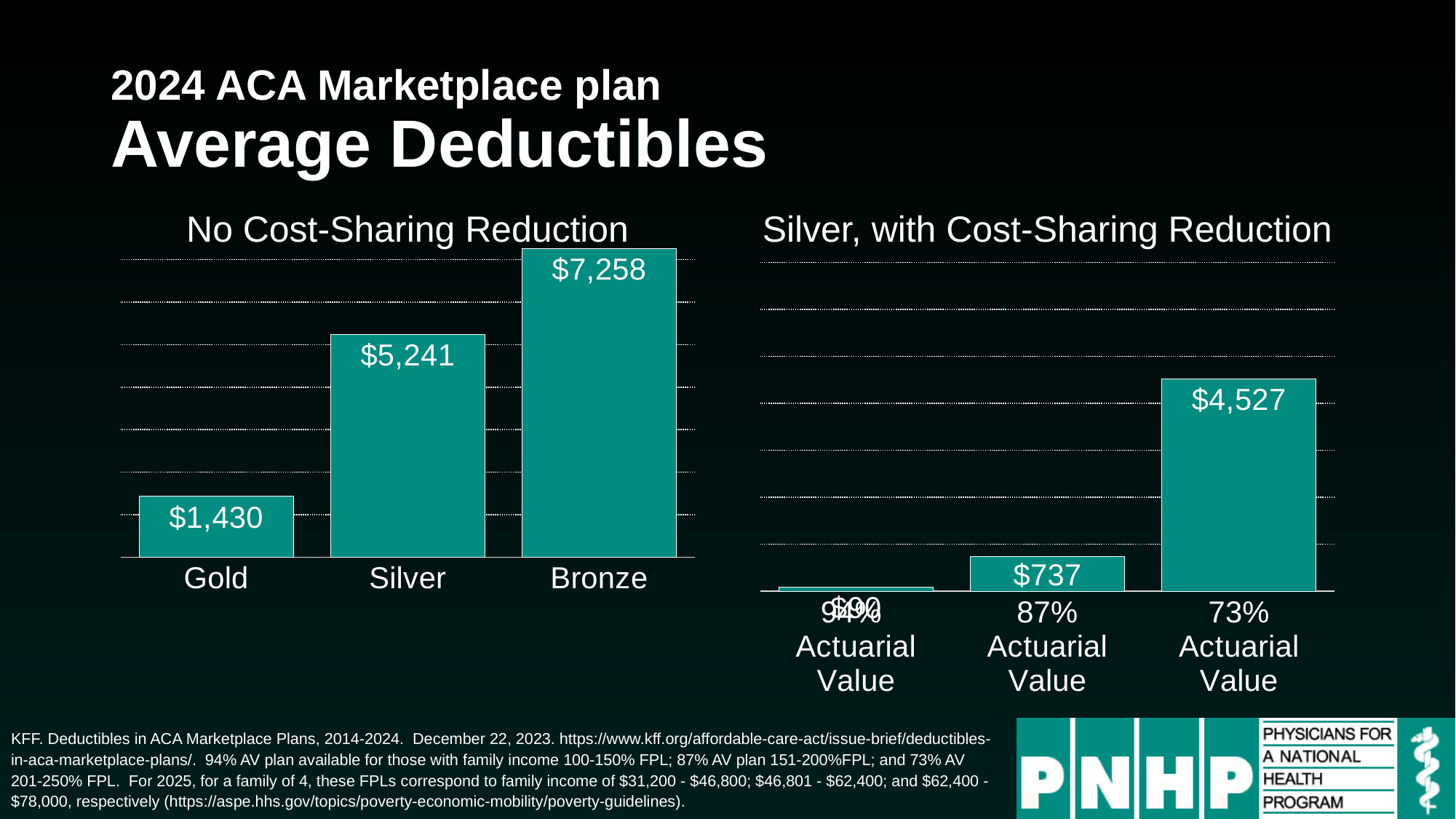
What type of chart is the 'No Cost-Sharing Reduction' chart? Bar chart In the 'Silver, with Cost-Sharing Reduction' chart, what is the average deductible for the 73% Actuarial Value plan? $4,527 In the 'Silver, with Cost-Sharing Reduction' chart, which actuarial value plan has the lowest average deductible? 94% Actuarial Value In the 'No Cost-Sharing Reduction' chart, what is the average deductible for Silver? $5,241 In the 'No Cost-Sharing Reduction' chart, which plan tier has the lowest average deductible? Gold In the 'No Cost-Sharing Reduction' chart, what is the difference between the Bronze and Silver deductibles? $2,017 In the 'Silver, with Cost-Sharing Reduction' chart, what is the average deductible for the 87% Actuarial Value plan? $737 In the 'No Cost-Sharing Reduction' chart, which plan tier has the highest average deductible? Bronze In the 'No Cost-Sharing Reduction' chart, what is the average deductible for Gold? $1,430 In the 'No Cost-Sharing Reduction' chart, how many plan tiers are shown? 3 In the 'Silver, with Cost-Sharing Reduction' chart, what is the difference between the 73% and 87% Actuarial Value deductibles? $3,790 Which is larger: the Silver deductible in the 'No Cost-Sharing Reduction' chart or the 73% Actuarial Value deductible in the 'Silver, with Cost-Sharing Reduction' chart? Silver in the 'No Cost-Sharing Reduction' chart